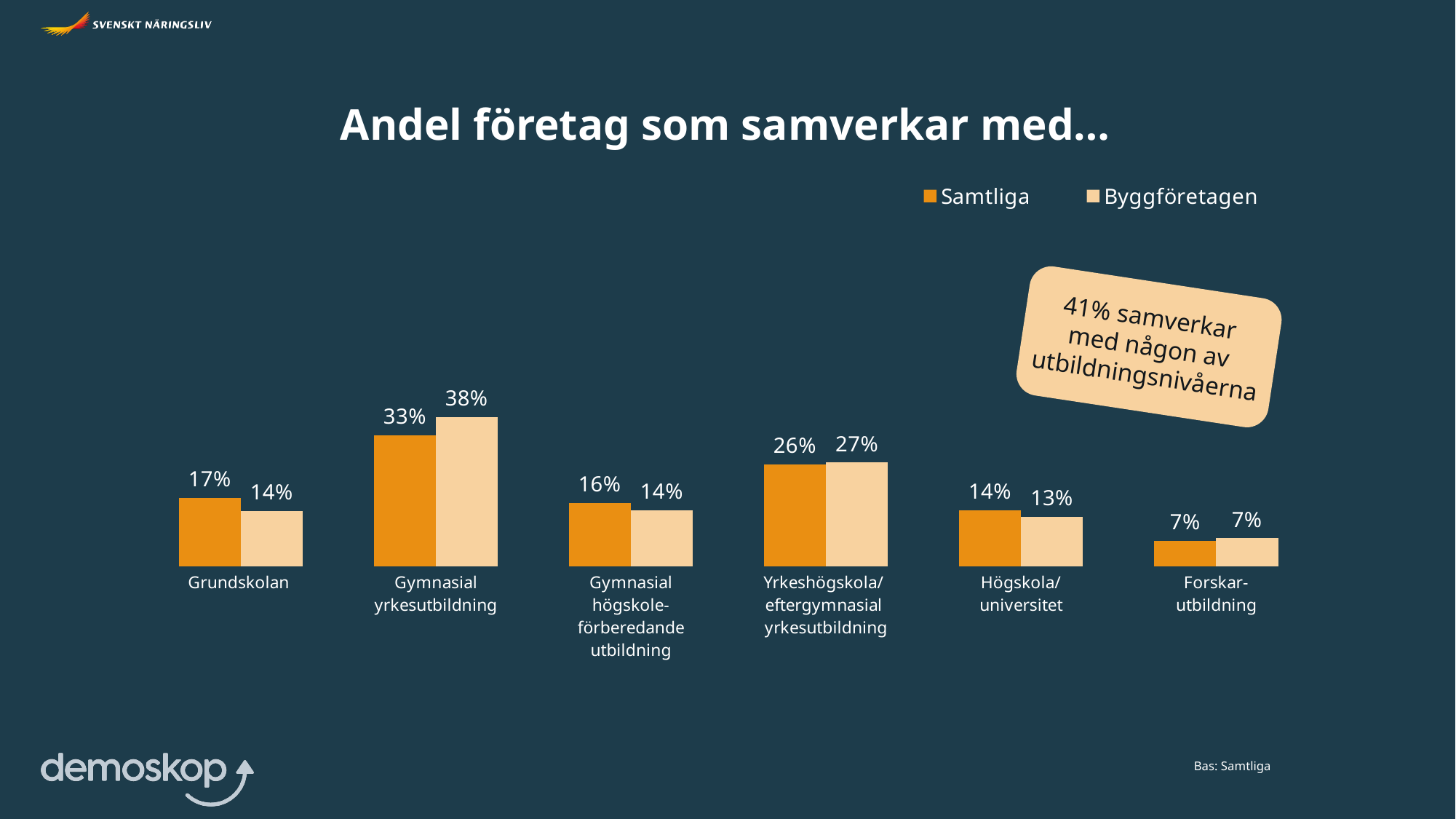
What is the Samtliga value for Yrkeshögskola/eftergymnasial yrkesutbildning? 26% What is the Samtliga value for Grundskolan? 17% How many series does the legend list? 2 What is the Byggföretagen value for Gymnasial yrkesutbildning? 38% What is the Byggföretagen value for Högskola/universitet? 13% What kind of chart is shown on the slide? Bar chart For Grundskolan, which series has the larger value, Samtliga or Byggföretagen? Samtliga What is the difference between the Byggföretagen and Samtliga values for Gymnasial yrkesutbildning? 5 percentage points Which category has the lowest Byggföretagen value? Forskarutbildning How many categories are shown on the x axis? 6 What is the title of the chart? Andel företag som samverkar med… Which category has the highest Samtliga value? Gymnasial yrkesutbildning